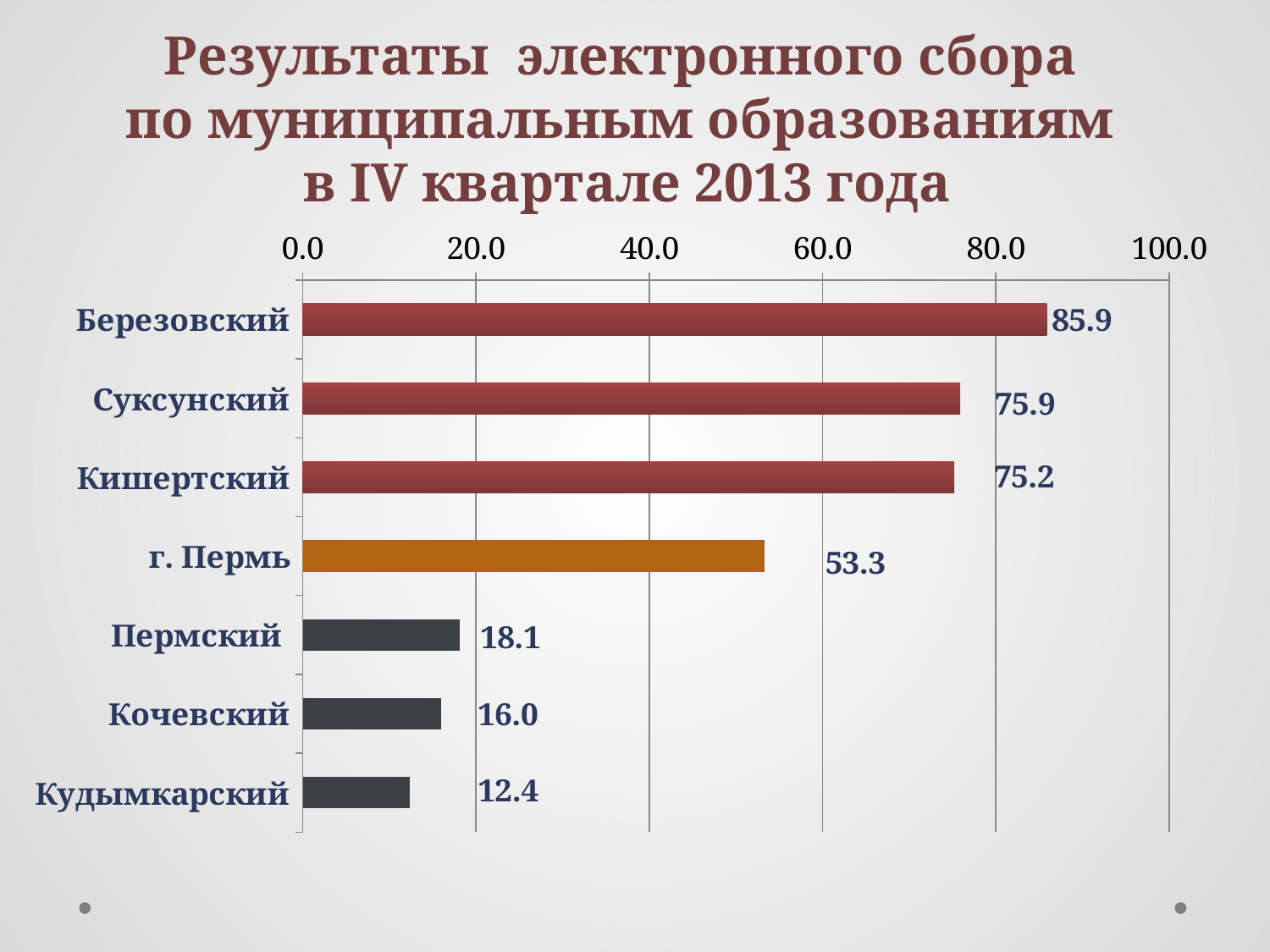
Which category has the highest value? Березовский What is the value for Березовский? 85.9 What is the difference between the values for Березовский and Суксунский? 10.0 What kind of chart is shown on the slide? bar chart What is the value for Кочевский? 16.0 What is the value for г. Пермь? 53.3 Which is larger, the value for Кишертский or the value for г. Пермь? Кишертский Which category's bar is coloured orange? г. Пермь How many categories are shown in the chart? 7 Which category has the lowest value? Кудымкарский Is the value for Суксунский greater or less than 60.0? greater What is the difference between the values for Пермский and Кудымкарский? 5.7